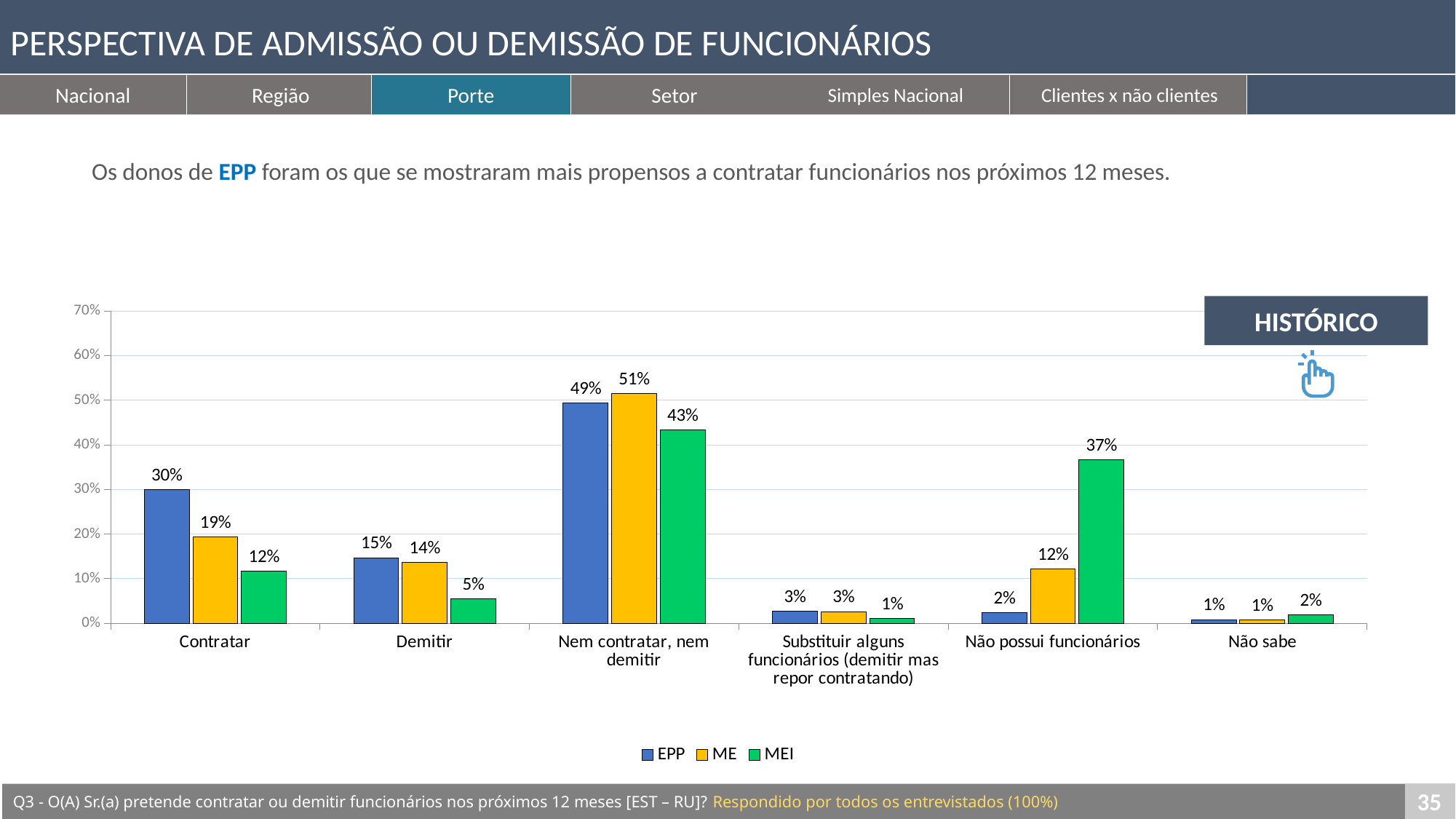
Which category has the highest value for the MEI series? Nem contratar, nem demitir What is the value for ME in the Nem contratar, nem demitir category? 51% In the Demitir category, which is larger: the EPP value or the MEI value? EPP Which series is shown in green in the legend? MEI Which category has the lowest value for the EPP series? Não sabe What is the difference between the ME and MEI values in the Não possui funcionários category? 25% What kind of chart is shown on the slide? Bar chart What is the value for EPP in the Contratar category? 30% How many categories are shown on the x axis? 6 What is the value for MEI in the Não possui funcionários category? 37% What is the difference between the EPP and MEI values in the Contratar category? 18% How many series does the legend list? 3